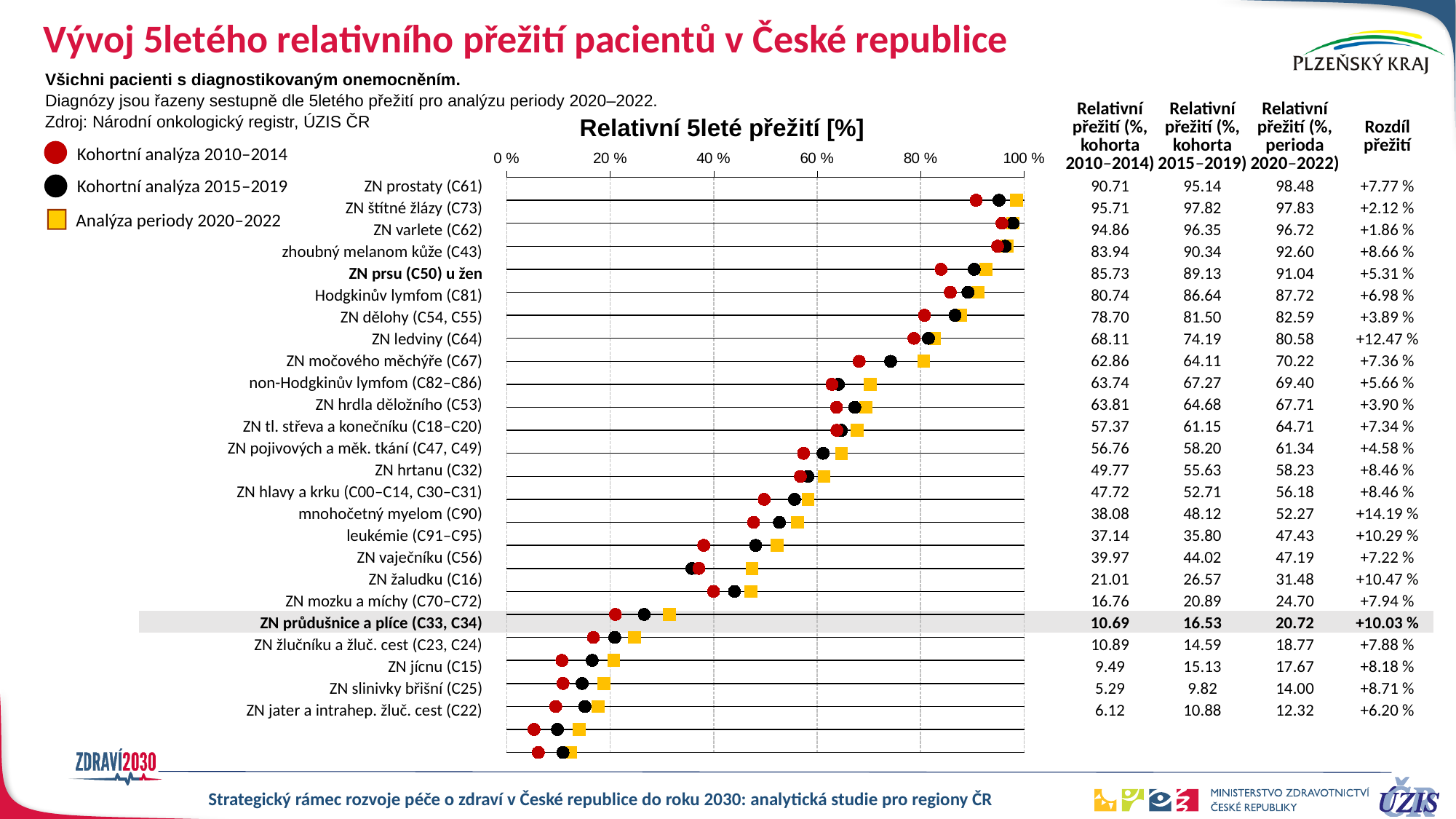
Which diagnosis has the lowest relative 5-year survival in the period analysis 2020–2022? ZN jater a intrahep. žluč. cest (C22) For leukémie (C91–C95), which is larger: the cohort 2010–2014 value or the cohort 2015–2019 value? cohort 2010–2014 What is the relative 5-year survival for leukémie (C91–C95) in the cohort analysis 2010–2014? 37.14 Is the period 2020–2022 value for ZN žaludku (C16) greater or less than 40 %? less How many diagnoses (categories) are plotted in the chart? 25 Which diagnosis has the highest relative 5-year survival in the period analysis 2020–2022? ZN prostaty (C61) What kind of chart is shown under the title "Relativní 5leté přežití [%]"? dot plot What is the difference in survival (Rozdíl přežití) for ZN ledviny (C64)? +12.47 % Which legend series is marked with a yellow square? Analýza periody 2020–2022 Which diagnosis shows the largest difference in survival (Rozdíl přežití)? mnohočetný myelom (C90) What is the relative 5-year survival for ZN prsu (C50) u žen in the period analysis 2020–2022? 91.04 How many series does the legend list? 3